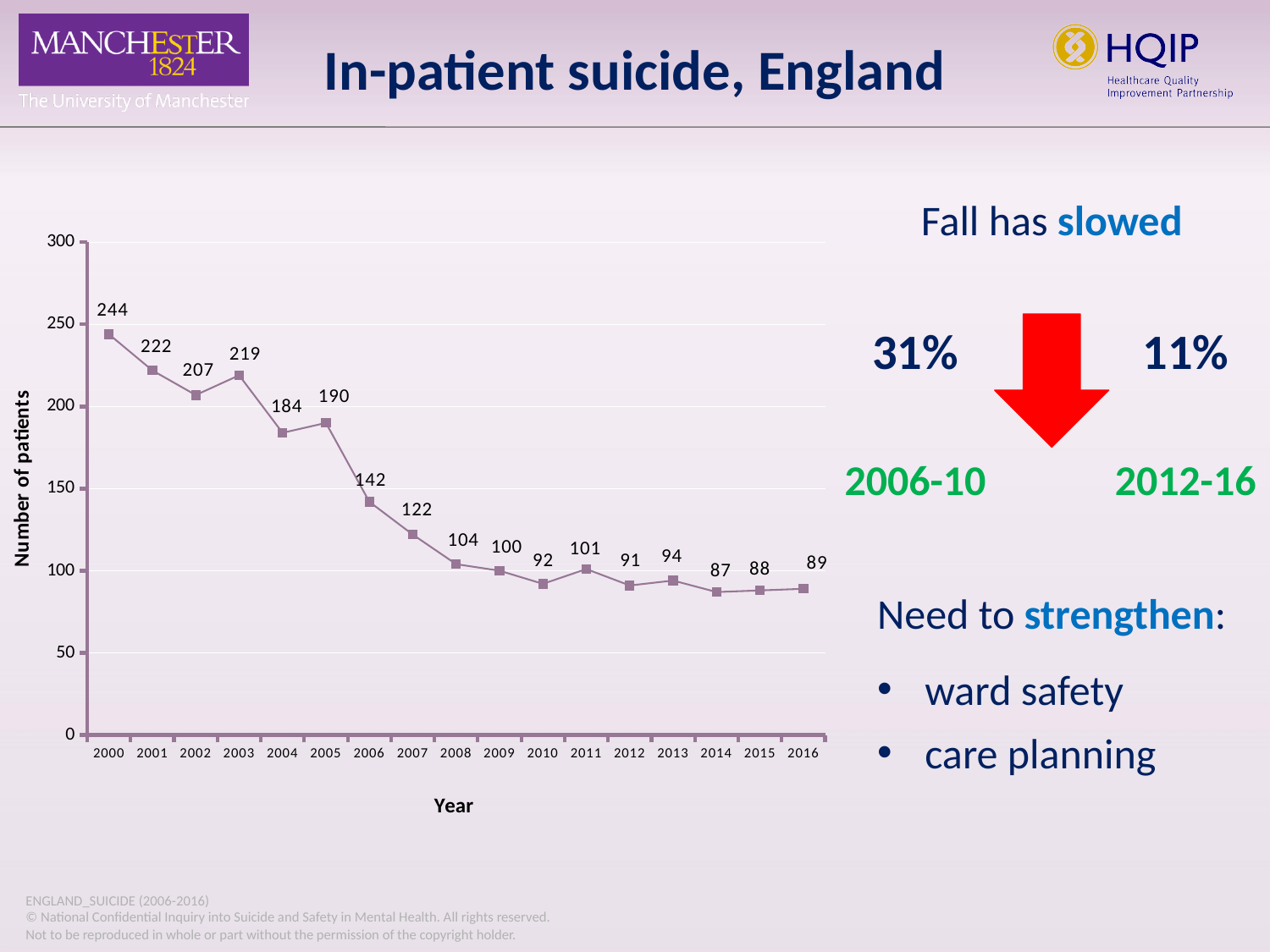
What is the label of the y axis? Number of patients Is the value for 2007 greater or less than 100? greater Which year has the highest number of patients? 2000 What kind of chart is shown on the slide? line chart What is the number of patients in 2000? 244 What is the number of patients in 2016? 89 What is the number of patients in 2006? 142 What is the difference in the number of patients between 2000 and 2016? 155 Do the values generally rise or fall from 2000 to 2016? fall Which year has more patients, 2005 or 2004? 2005 Which year has the lowest number of patients? 2014 How many years are plotted on the x axis? 17